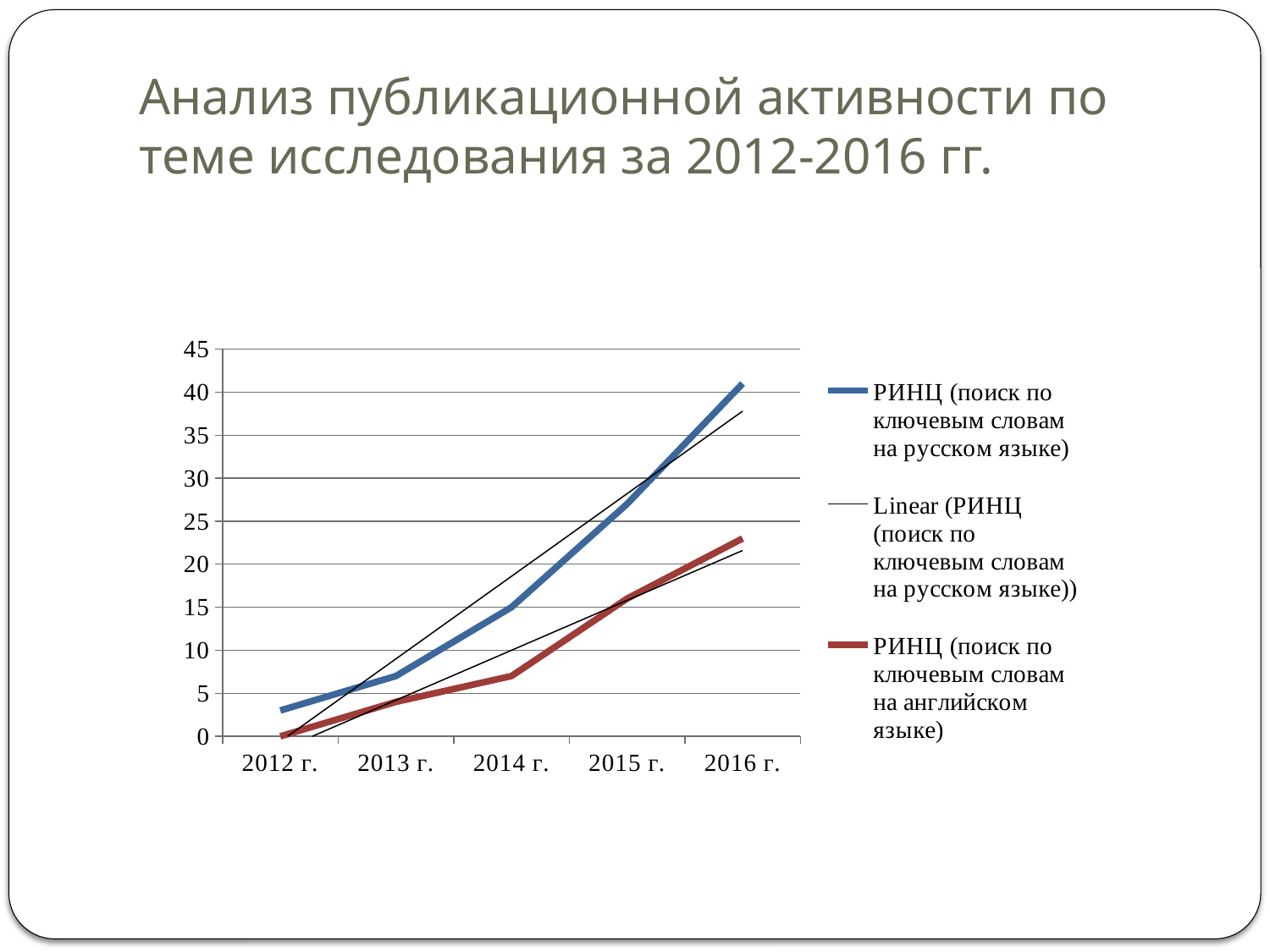
Is the value for РИНЦ (поиск по ключевым словам на русском языке) in 2014 г. greater or less than 10? greater Do the values for РИНЦ (поиск по ключевым словам на русском языке) rise or fall from 2012 г. to 2016 г.? rise Which year has the lowest value for the series РИНЦ (поиск по ключевым словам на английском языке)? 2012 г. In 2015 г., which series has the larger value: РИНЦ (поиск по ключевым словам на русском языке) or РИНЦ (поиск по ключевым словам на английском языке)? РИНЦ (поиск по ключевым словам на русском языке) Is the value for РИНЦ (поиск по ключевым словам на английском языке) in 2016 г. greater or less than 25? less Which year has the highest value for the series РИНЦ (поиск по ключевым словам на русском языке)? 2016 г. How many entries does the chart legend list? 3 How many years are shown on the x axis of the chart? 5 What colour is the line for РИНЦ (поиск по ключевым словам на английском языке)? red Is the value for РИНЦ (поиск по ключевым словам на английском языке) in 2014 г. greater or less than 10? less What kind of chart is shown on the slide? line chart